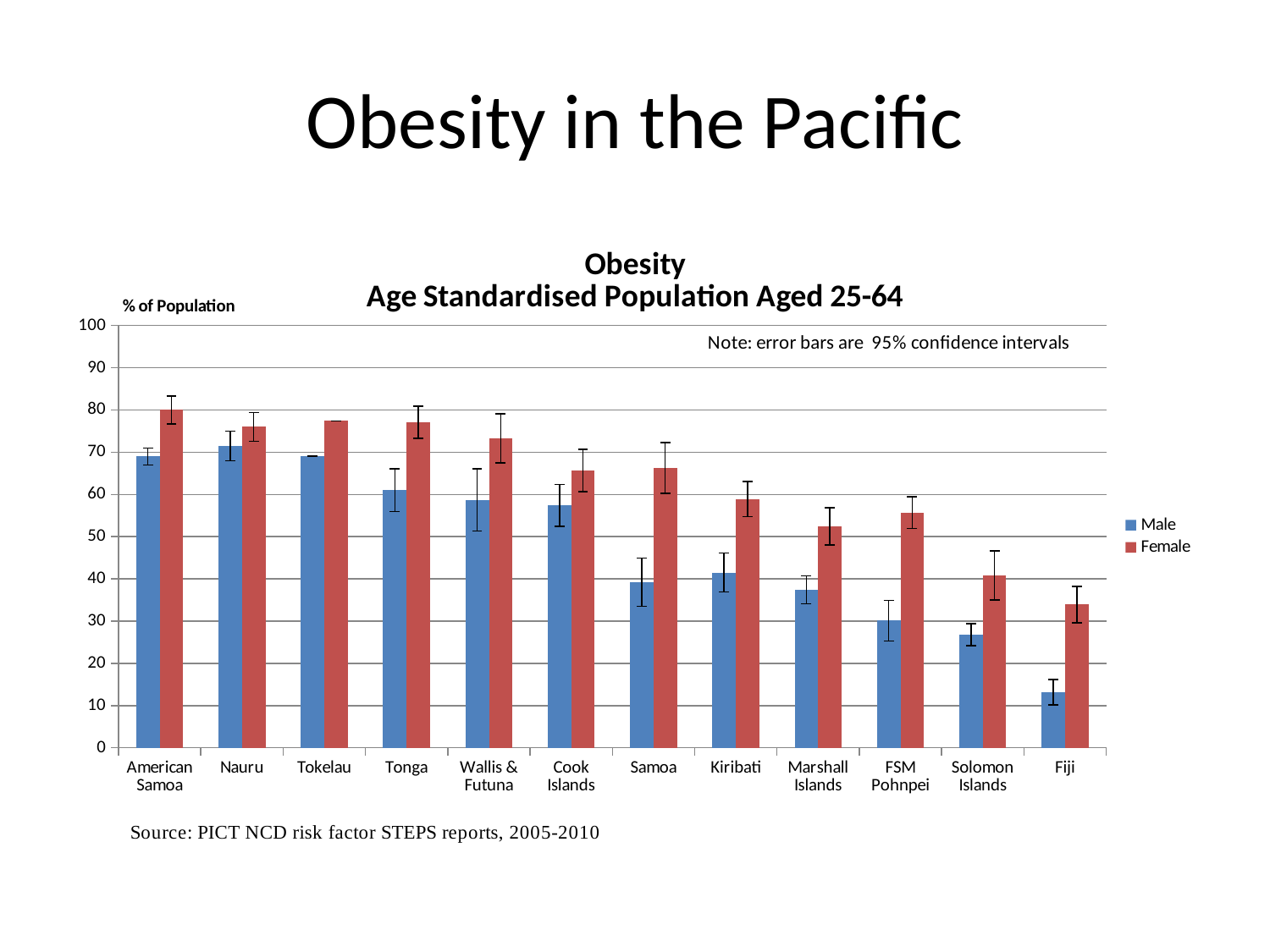
Is the Female value for Tonga greater or less than 70? greater Which country has the lowest Female obesity value? Fiji Do the Male values generally rise or fall moving from left to right along the x axis? fall Which country has the highest Female obesity value? American Samoa What kind of chart is shown on the slide? bar chart Which is larger, the Male value for Tonga or the Male value for Samoa? Tonga Which country has the lowest Male obesity value? Fiji Is the Male value for Fiji greater or less than 20? less According to the note on the chart, what do the error bars represent? 95% confidence intervals Is the Female value for Kiribati greater or less than 50? greater How many countries or territories are shown on the x axis? 12 How many series does the legend list? 2